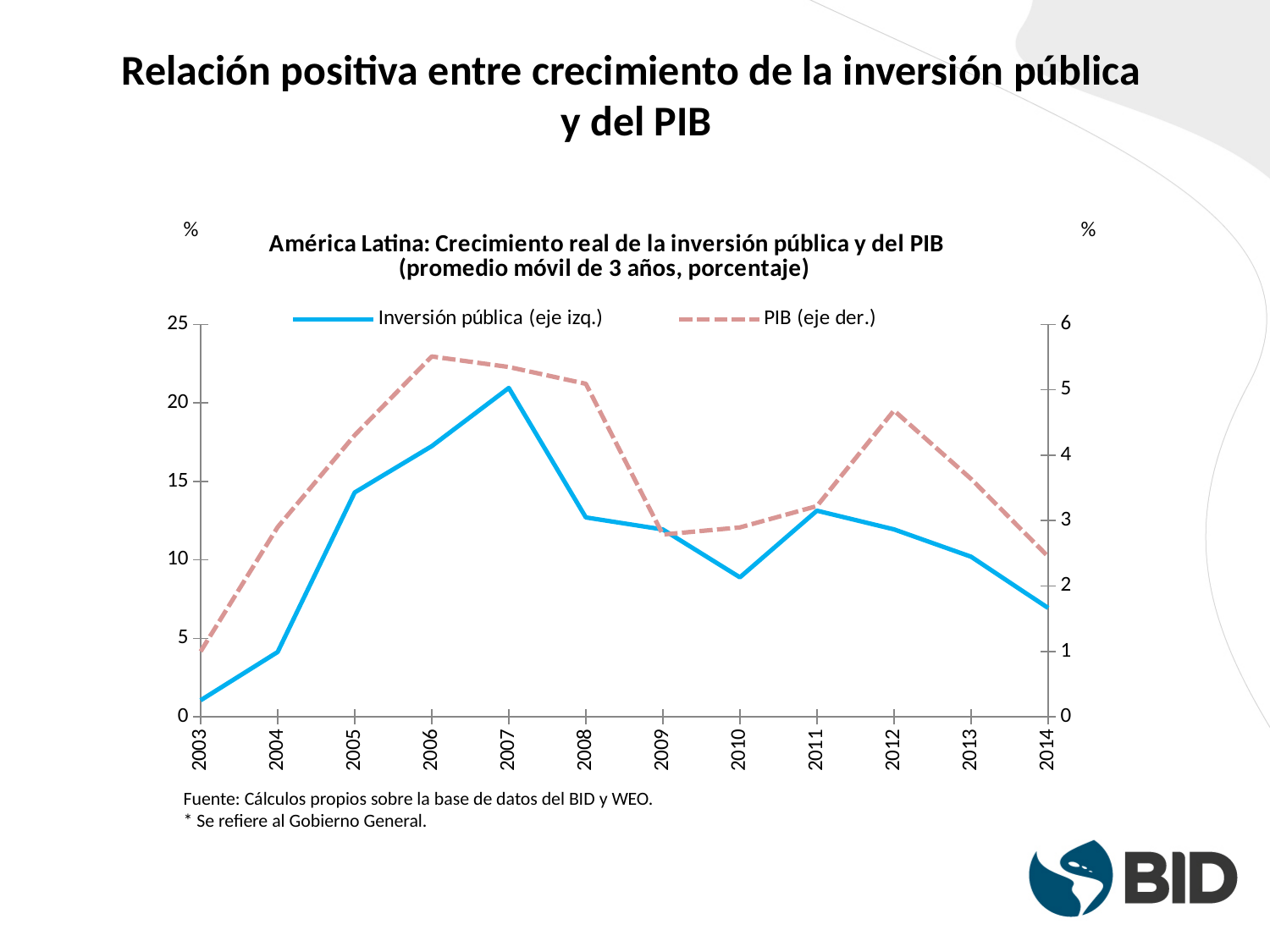
In which year does the PIB (eje der.) series reach its highest value? 2006 What kind of chart is shown on the slide? Line chart In which year is the Inversión pública (eje izq.) series at its lowest? 2003 Does the Inversión pública (eje izq.) series rise or fall from 2011 to 2014? Falls Is the value for Inversión pública (eje izq.) in 2007 greater or less than 15? greater In which year is the PIB (eje der.) series at its lowest? 2003 In which year does the Inversión pública (eje izq.) series reach its highest value? 2007 Is the value for PIB (eje der.) in 2012 greater or less than 4? greater How many years are plotted along the x axis? 12 How many series does the legend list? 2 Which year has the larger value for Inversión pública (eje izq.), 2005 or 2010? 2005 Is the value for Inversión pública (eje izq.) in 2014 greater or less than 10? less